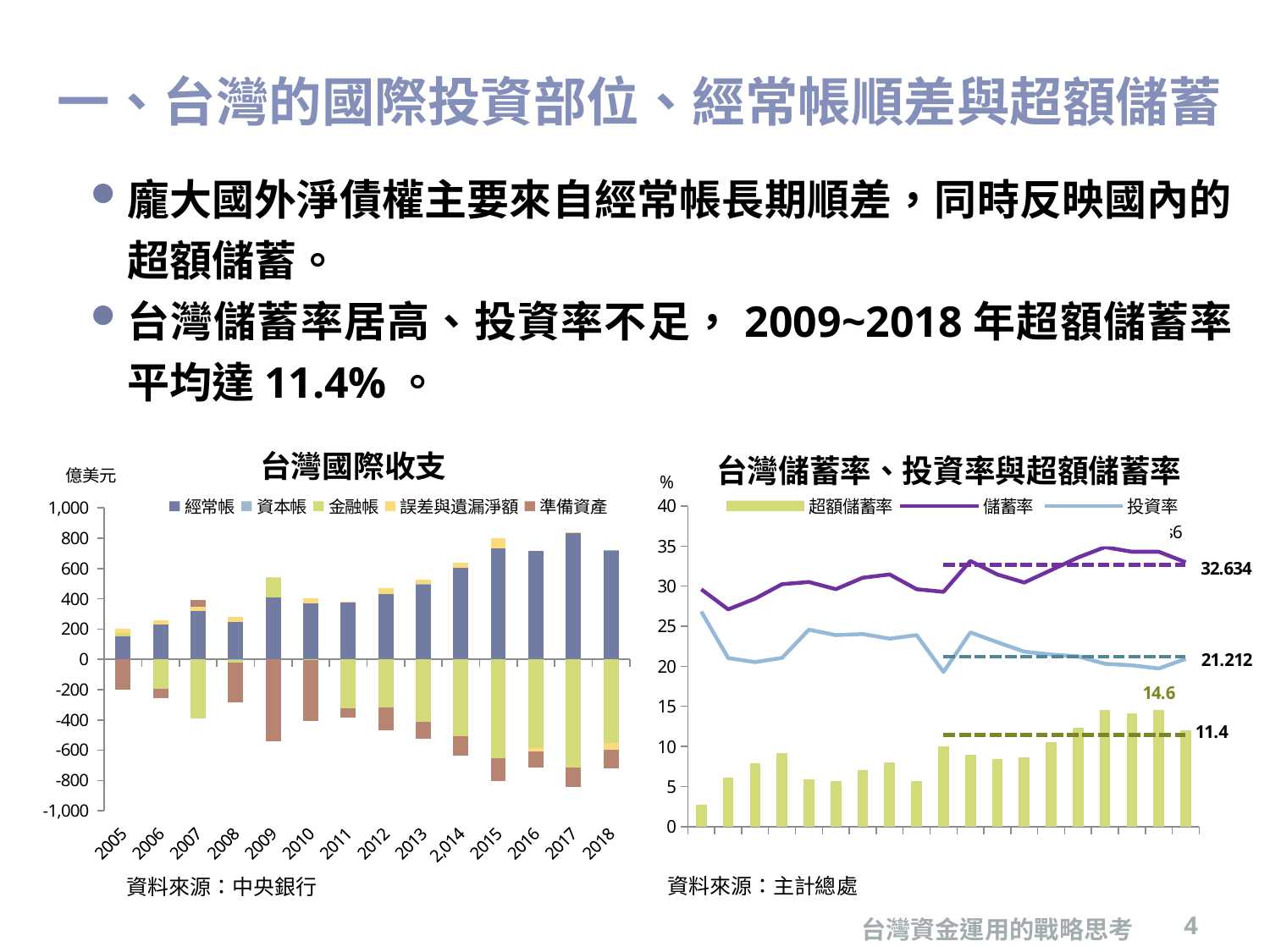
In the 台灣儲蓄率、投資率與超額儲蓄率 chart, which line is higher throughout the period: 儲蓄率 or 投資率? 儲蓄率 In the 台灣儲蓄率、投資率與超額儲蓄率 chart, what value is labeled on the dashed line for 投資率? 21.212 How many series does the legend of the 台灣國際收支 chart list? 5 In the 台灣國際收支 chart, which is larger: the 經常帳 value for 2017 or for 2005? 2017 In the 台灣國際收支 chart, is the 經常帳 value for 2015 greater or less than 600? greater How many years are shown on the x axis of the 台灣國際收支 chart? 14 In the 台灣國際收支 chart, which year has the highest 經常帳 value? 2017 What kind of chart is the 台灣國際收支 chart on the left? Stacked bar chart In the 台灣儲蓄率、投資率與超額儲蓄率 chart, what value is labeled on the purple dashed line for 儲蓄率? 32.634 How many series does the legend of the 台灣儲蓄率、投資率與超額儲蓄率 chart list? 3 In the 台灣國際收支 chart, does the 經常帳 series generally rise or fall from 2005 to 2018? Rise In the 台灣國際收支 chart, in which year is the negative 準備資產 segment largest in magnitude? 2009